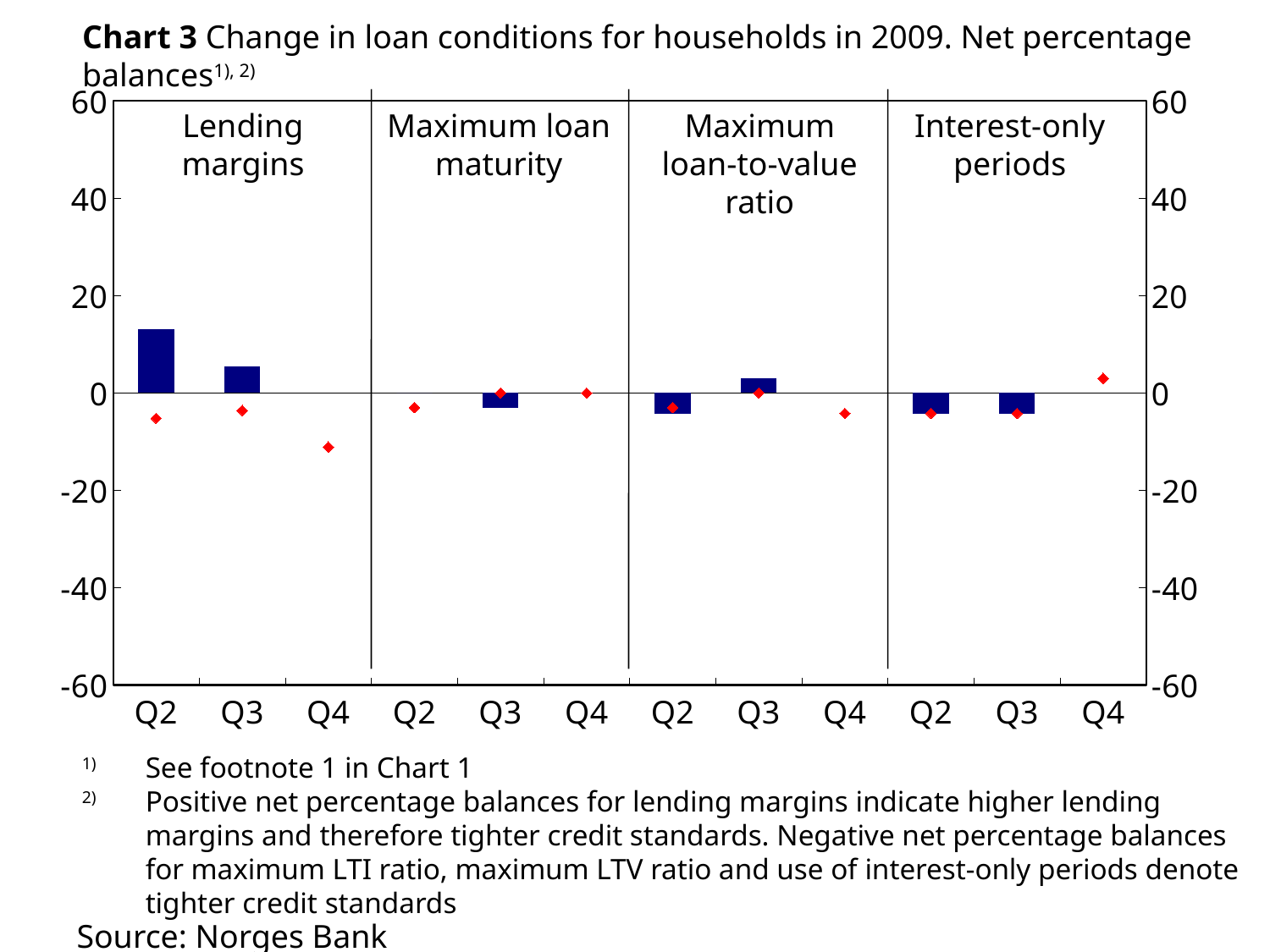
What kind of chart is Chart 3? bar chart How many quarters are shown on the x axis within each panel of Chart 3? 3 Is the Q4 red marker for Lending margins greater or less than -20? greater Is the Q2 bar for Lending margins greater or less than 0? greater Is the Q3 bar for Maximum loan-to-value ratio greater or less than 0? greater Which bar is the tallest in Chart 3? Lending margins, Q2 How many loan condition panels are shown in Chart 3? 4 Which is larger for Lending margins, the Q2 bar or the Q3 bar? Q2 Which red marker is the lowest in Chart 3? Lending margins, Q4 What is the source given for Chart 3? Norges Bank